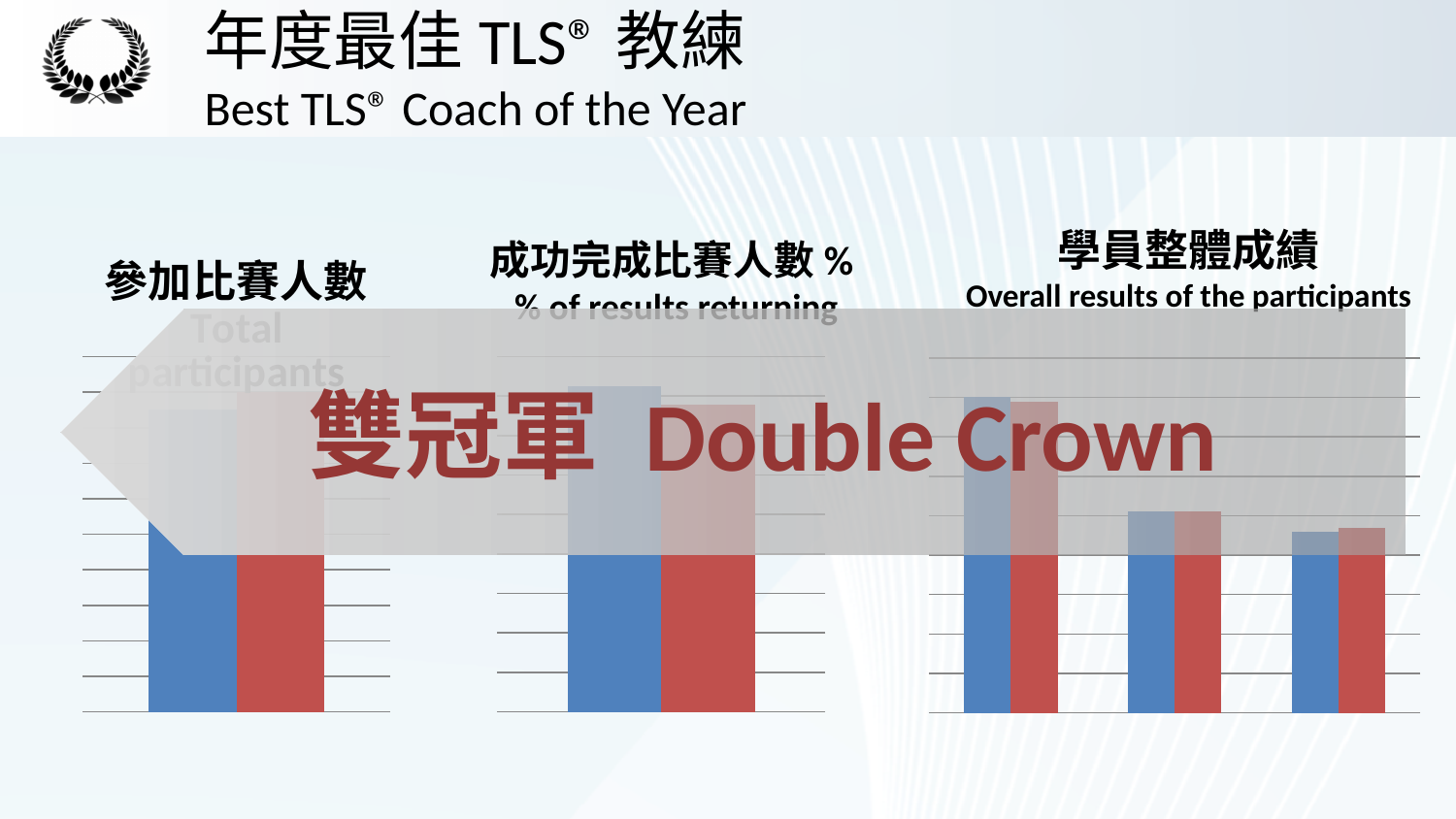
What two colours are used for the bars in the charts on this slide? blue and red What kind of chart is the leftmost chart titled 'Total participants'? bar chart What kind of chart is the rightmost chart titled 'Overall results of the participants'? bar chart How many groups of bars are shown in the rightmost chart titled 'Overall results of the participants'? 3 In the rightmost chart titled 'Overall results of the participants', do the bar heights rise or fall from left to right? fall How many bars are shown in the leftmost chart titled 'Total participants'? 2 How many bars are shown in the middle chart titled '% of results returning'? 2 In the middle chart titled '% of results returning', which bar is taller, the blue bar or the red bar? blue What is the English title of the leftmost chart? Total participants In the rightmost chart titled 'Overall results of the participants', which group of bars is the tallest: the first, second or third? first In the rightmost chart titled 'Overall results of the participants', which group of bars is the shortest: the first, second or third? third